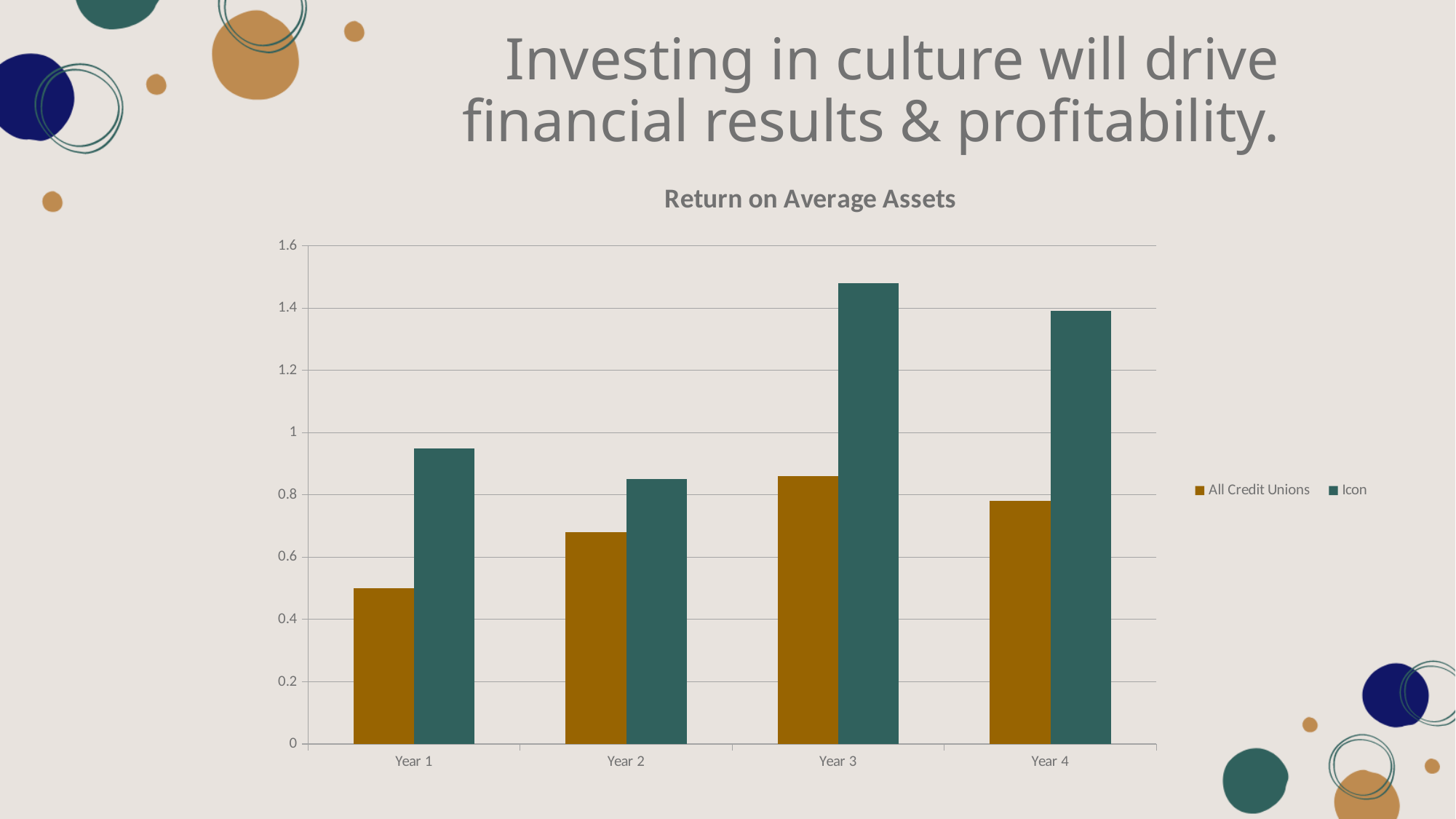
In which year is the Icon value highest? Year 3 In which year is the All Credit Unions value lowest? Year 1 Is the All Credit Unions value for Year 2 greater or less than 0.8? less In Year 4, which series has the larger value, All Credit Unions or Icon? Icon What is the title of the chart? Return on Average Assets How many year categories are shown on the x axis? 4 What kind of chart is shown on the slide? bar chart Is the Icon value for Year 3 greater or less than 1.4? greater Does the All Credit Unions value rise or fall from Year 1 to Year 3? rise In which year is the All Credit Unions value highest? Year 3 In which year is the Icon value lowest? Year 2 How many series does the legend list? 2